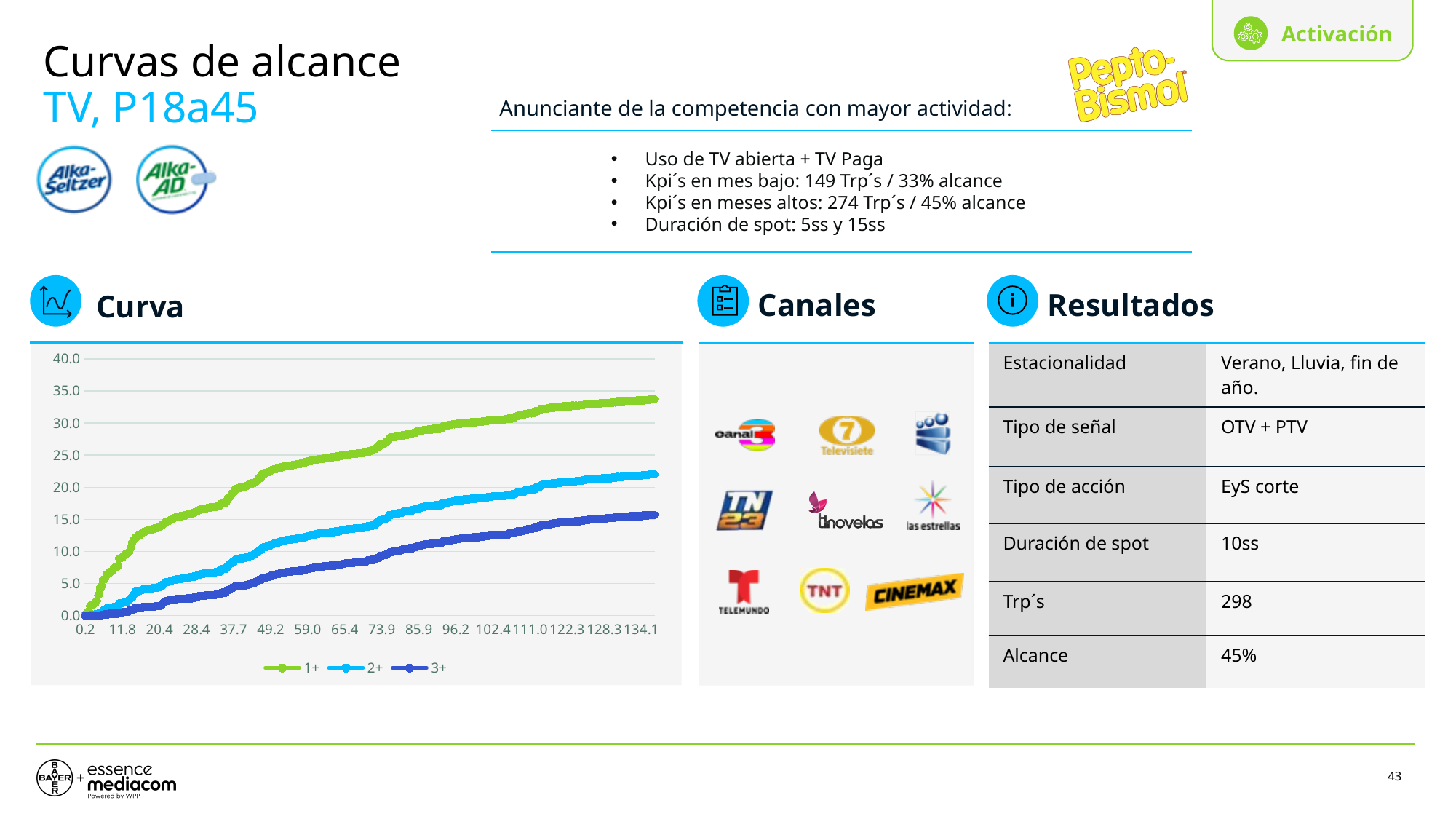
What kind of chart is shown under the "Curva" heading? line chart Is the value of the 1+ series at x = 134.1 greater or less than 30? greater At x = 73.9, which series has the larger value, 2+ or 3+? 2+ Is the value of the 3+ series at x = 49.2 greater or less than 10? less Is the value of the 3+ series at x = 134.1 greater or less than 20? less What are the series names in the legend of the line chart? 1+, 2+, 3+ How many series does the legend of the line chart list? 3 Do the values of the 1+ series rise or fall along the x axis? rise Which series has the highest value at the right end of the line chart (x = 134.1)? 1+ Which series in the line chart is drawn in green? 1+ Which series has the lowest value at the right end of the line chart (x = 134.1)? 3+